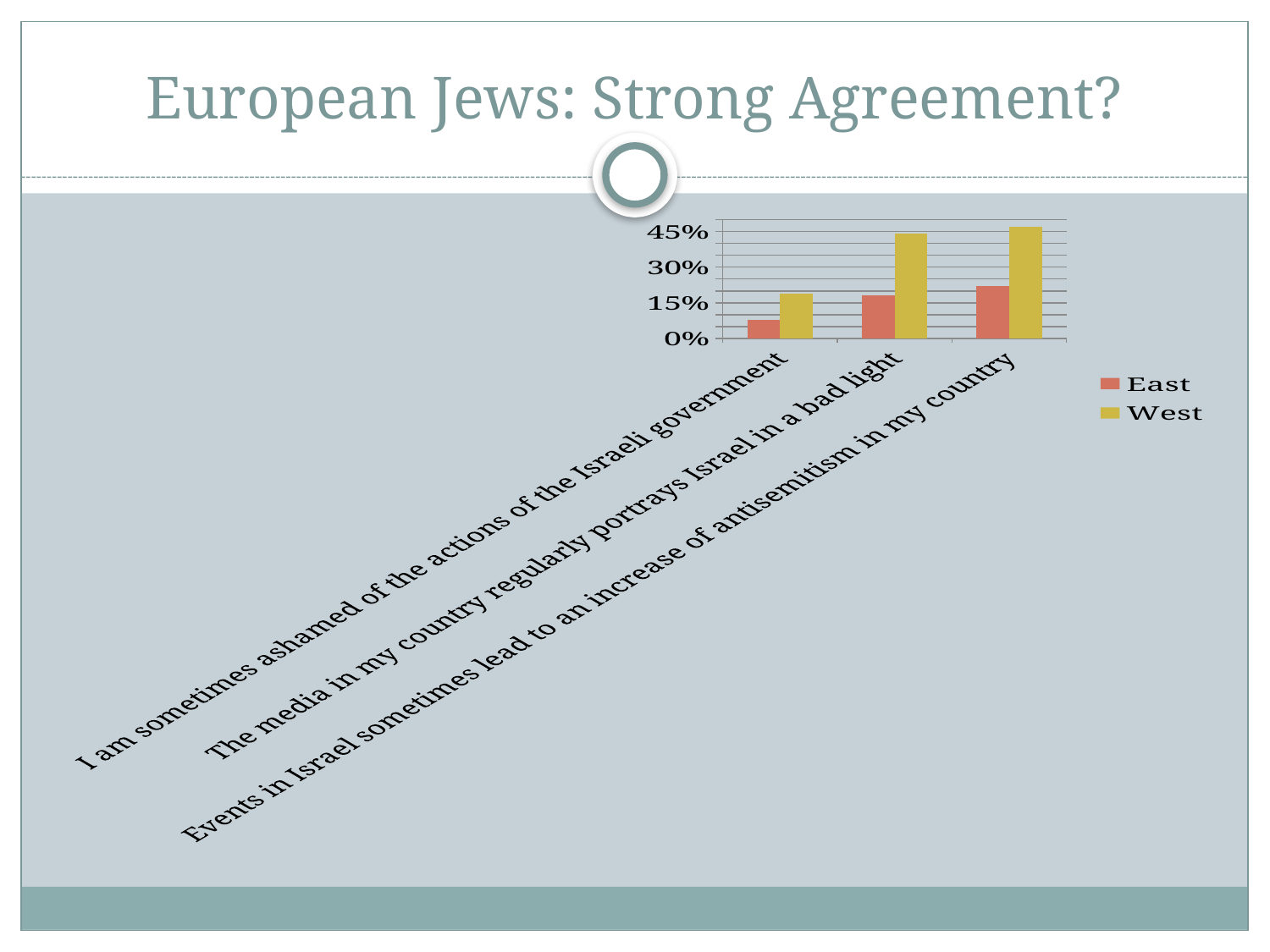
How many series does the chart's legend list? 2 Is the East value for "I am sometimes ashamed of the actions of the Israeli government" greater or less than 15%? less Do the West values rise or fall moving from left to right across the three statements? rise Is the West value for "The media in my country regularly portrays Israel in a bad light" greater or less than 30%? greater What are the two series named in the chart's legend? East and West Which statement has the lowest East value? I am sometimes ashamed of the actions of the Israeli government What kind of chart is shown on the slide? bar chart Which series has the higher value for "The media in my country regularly portrays Israel in a bad light", East or West? West Which statement has the highest West value? Events in Israel sometimes lead to an increase of antisemitism in my country Is the East value for "Events in Israel sometimes lead to an increase of antisemitism in my country" greater or less than 15%? greater Which series has the higher value for "Events in Israel sometimes lead to an increase of antisemitism in my country", East or West? West How many categories (statements) are shown on the x axis of the chart? 3